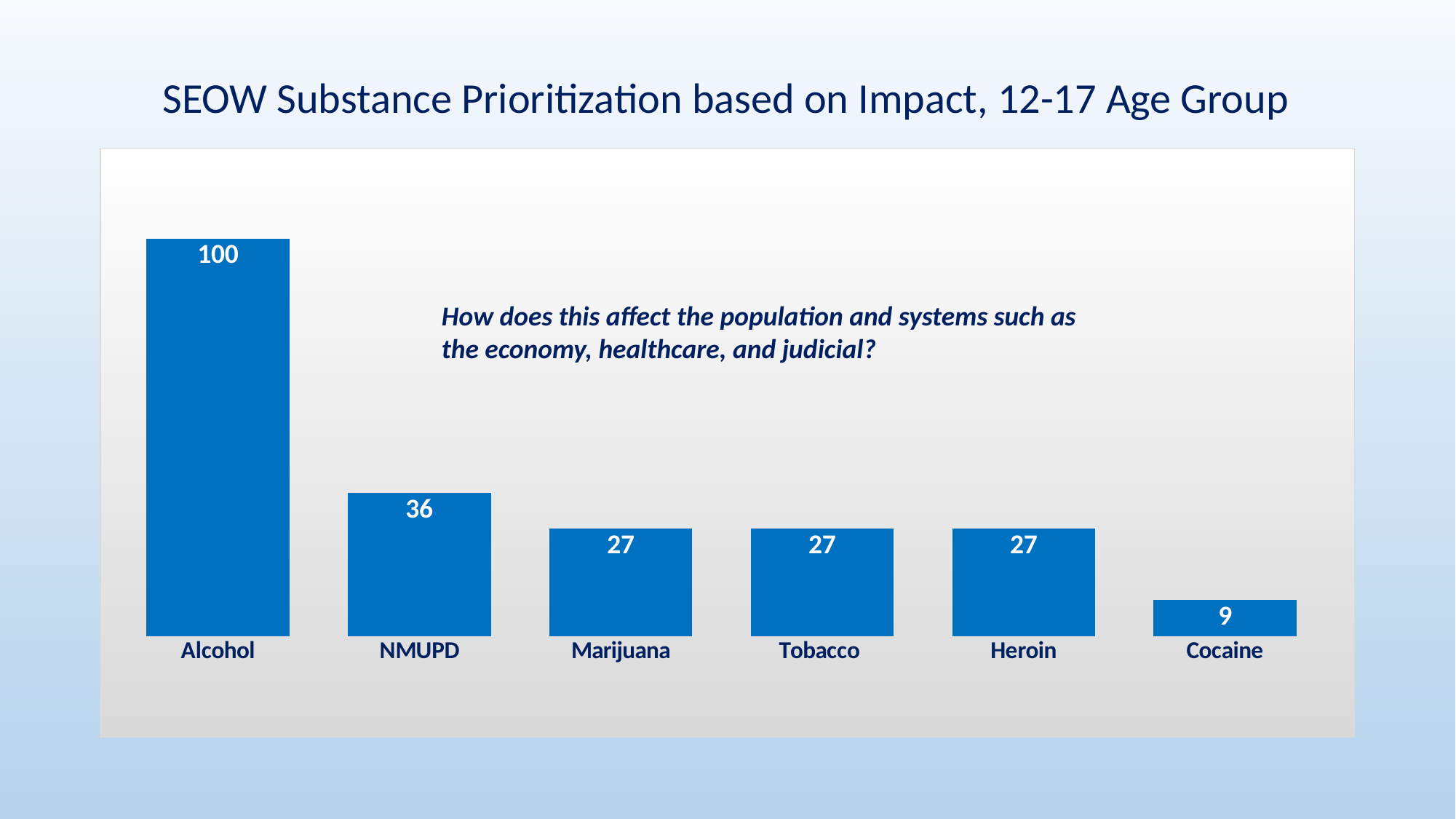
Which is larger, the value for NMUPD or the value for Marijuana? NMUPD What is the value for Tobacco? 27 What is the value for Alcohol? 100 What is the value for NMUPD? 36 What is the difference between the values for Heroin and Cocaine? 18 Do the values rise or fall from left to right across the chart? Fall Which substance has the highest value? Alcohol What is the value for Cocaine? 9 How many substances are shown in the chart? 6 Which substance has the lowest value? Cocaine What is the difference between the values for Alcohol and NMUPD? 64 What kind of chart is shown on the slide? Bar chart